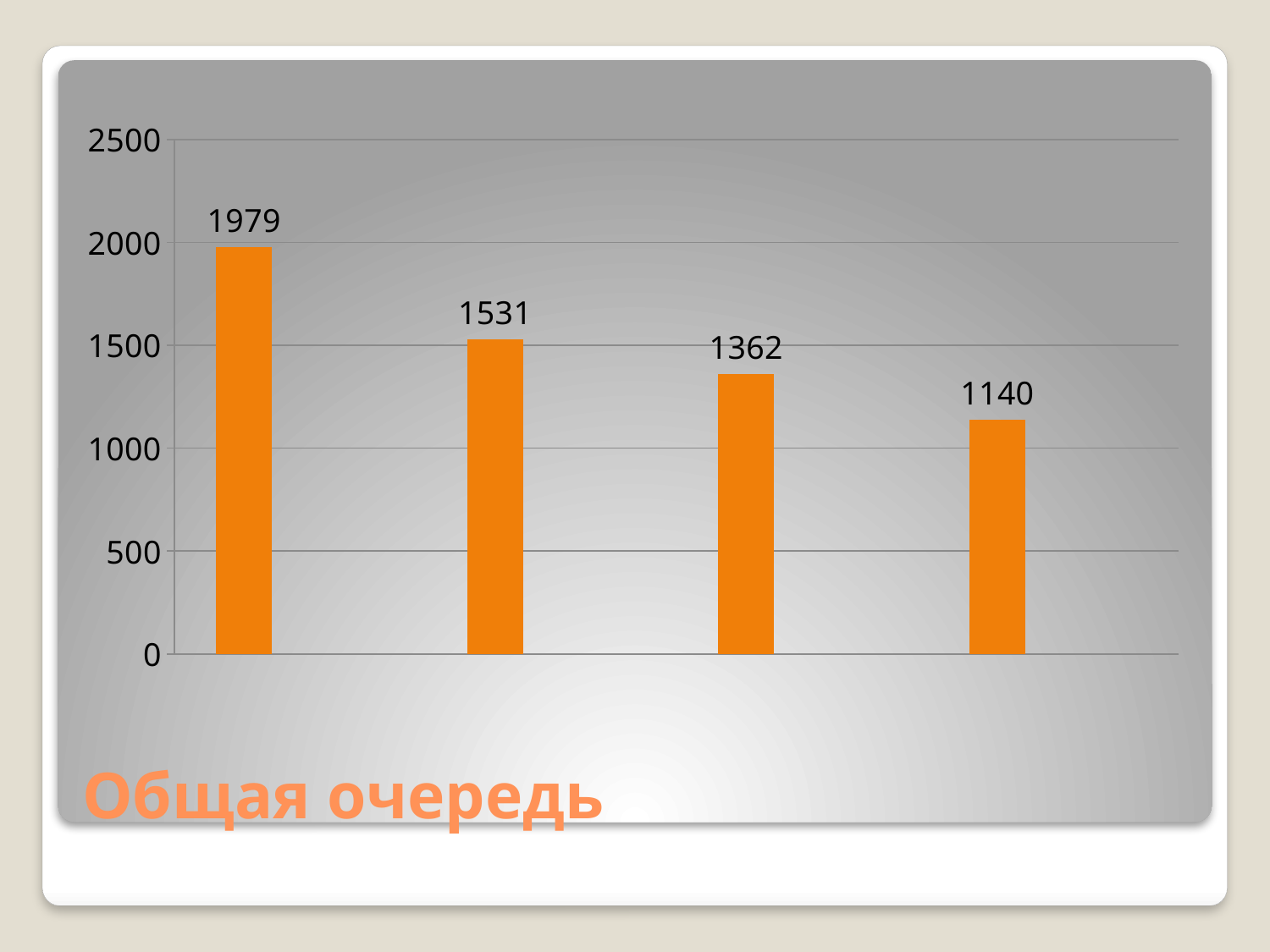
Is the value of the third bar greater or less than 1500? less What type of chart is shown on the slide? Bar chart How many bars are plotted in the chart? 4 What is the value of the first (leftmost) bar? 1979 What is the value of the second bar from the left? 1531 What is the difference between the first bar (1979) and the last bar (1140)? 839 Which bar has the highest value? The first (leftmost) bar, 1979 What is the value of the third bar from the left? 1362 Which bar has the lowest value? The fourth (rightmost) bar, 1140 What is the value of the fourth (rightmost) bar? 1140 Which is larger, the second bar or the third bar? The second bar (1531) Do the bar values rise or fall from left to right? Fall